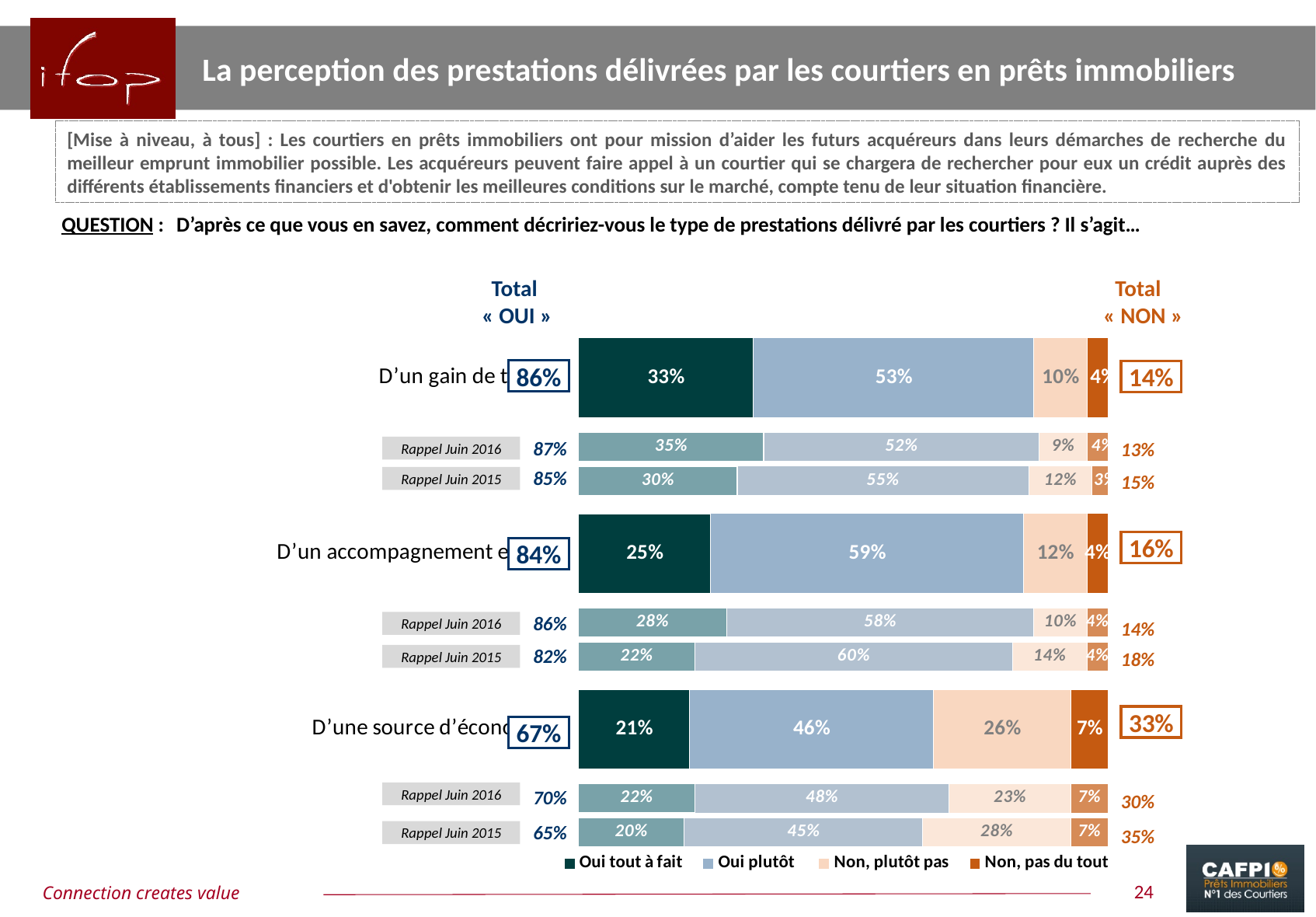
In the top main bar (D'un gain de t...), what is the value for 'Oui tout à fait'? 33% Which has the larger 'Oui plutôt' value: the top main bar or the middle main bar? The middle main bar (59%) In the Rappel Juin 2015 row under the bottom category (D'une source d'écono...), what is the value for 'Non, plutôt pas'? 28% What kind of chart is shown on the slide? Stacked bar chart What is the Total « OUI » for the Rappel Juin 2016 row under the top category (D'un gain de t...)? 87% What is the difference between the Total « OUI » of the top main bar (86%) and the bottom main bar (67%)? 19 points How many main (current-year) categories are plotted in the chart? 3 In the bottom main bar (D'une source d'écono...), what is the value for 'Oui plutôt'? 46% Which of the three main bars has the highest Total « NON »? D'une source d'écono... (bottom bar) How many series does the legend list? 4 What is the Total « NON » for the bottom main bar (D'une source d'écono...)? 33% What is the Total « OUI » for the middle main bar (D'un accompagnement e...)? 84%